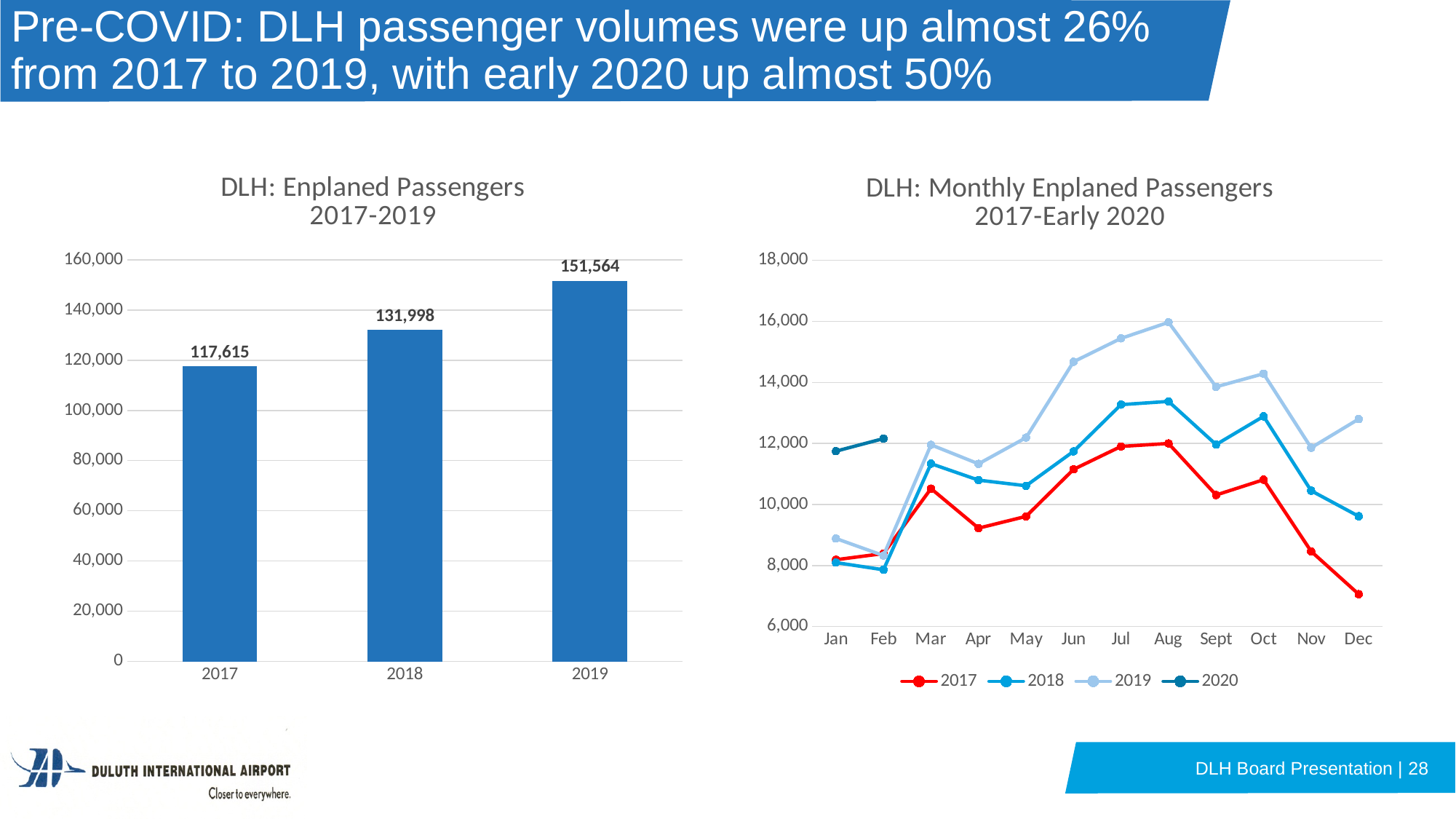
In the 'DLH: Enplaned Passengers 2017-2019' chart, what is the value for 2018? 131,998 What kind of chart is 'DLH: Enplaned Passengers 2017-2019'? Bar chart In the 'DLH: Enplaned Passengers 2017-2019' chart, which year has the highest value? 2019 In the 'DLH: Monthly Enplaned Passengers 2017-Early 2020' chart, is the 2017 value for Dec greater or less than 8,000? less How many series does the legend of the 'DLH: Monthly Enplaned Passengers 2017-Early 2020' chart list? 4 In the 'DLH: Monthly Enplaned Passengers 2017-Early 2020' chart, which series is larger in Jul, 2018 or 2017? 2018 In the 'DLH: Enplaned Passengers 2017-2019' chart, what is the difference between the 2019 and 2017 values? 33,949 What kind of chart is 'DLH: Monthly Enplaned Passengers 2017-Early 2020'? Line chart In the 'DLH: Monthly Enplaned Passengers 2017-Early 2020' chart, which month has the highest value for the 2019 series? Aug In the 'DLH: Enplaned Passengers 2017-2019' chart, how many bars are shown? 3 In the 'DLH: Enplaned Passengers 2017-2019' chart, do the values rise or fall from 2017 to 2019? Rise In the 'DLH: Enplaned Passengers 2017-2019' chart, what is the value for 2017? 117,615